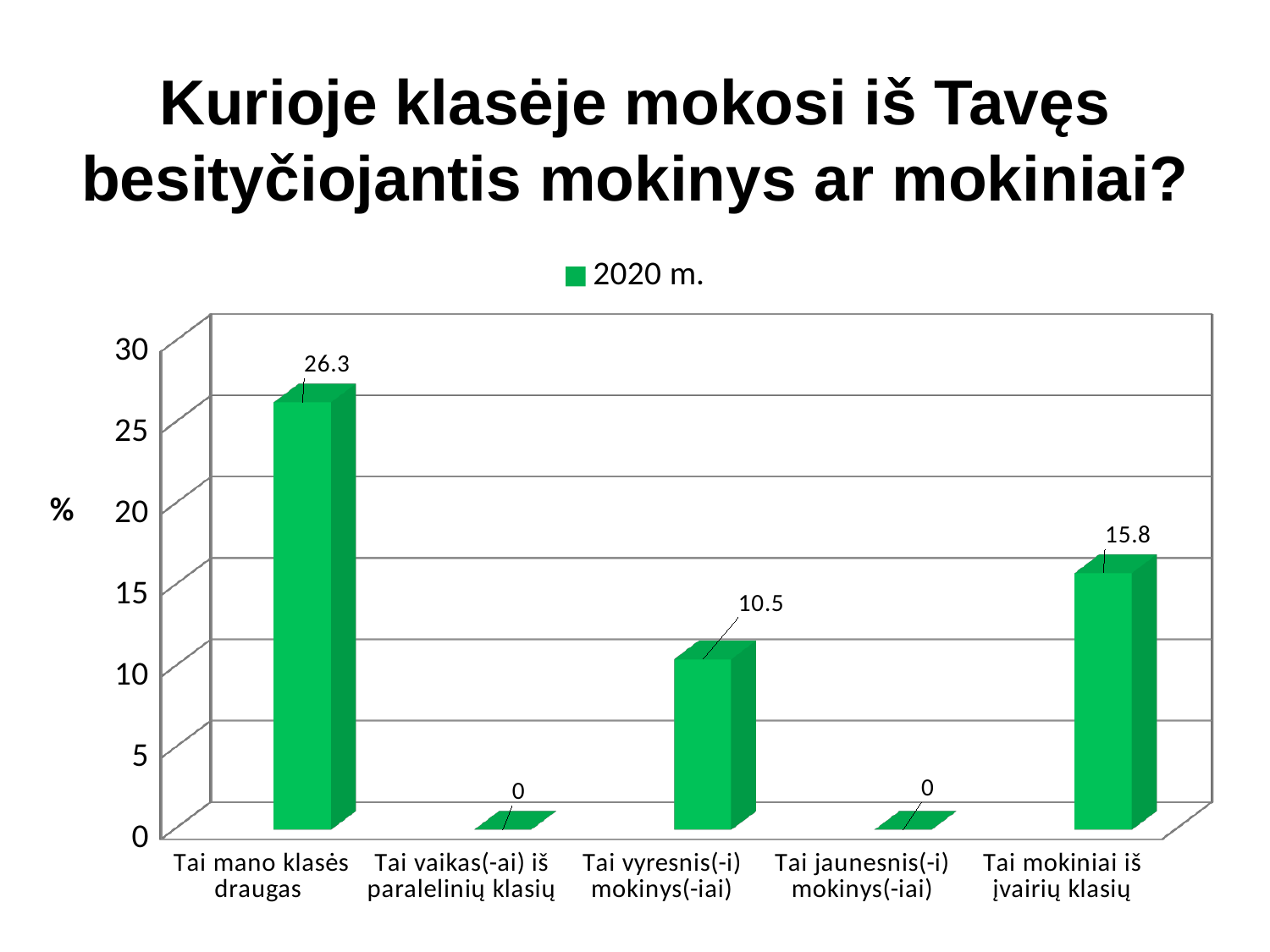
What is the difference between the values for "Tai mokiniai iš įvairių klasių" and "Tai vyresnis(-i) mokinys(-iai)"? 5.3 What is the value for "Tai vaikas(-ai) iš paralelinių klasių"? 0 What is the value for "Tai mano klasės draugas"? 26.3 What kind of chart is shown on the slide? Bar chart Which is larger, the value for "Tai vyresnis(-i) mokinys(-iai)" or for "Tai mokiniai iš įvairių klasių"? Tai mokiniai iš įvairių klasių What is the value for "Tai mokiniai iš įvairių klasių"? 15.8 What series name is shown in the legend? 2020 m. Which category has the highest value? Tai mano klasės draugas How many categories are shown on the x axis? 5 What is the value for "Tai vyresnis(-i) mokinys(-iai)"? 10.5 What is the difference between the values for "Tai mano klasės draugas" and "Tai mokiniai iš įvairių klasių"? 10.5 How many series does the legend list? 1